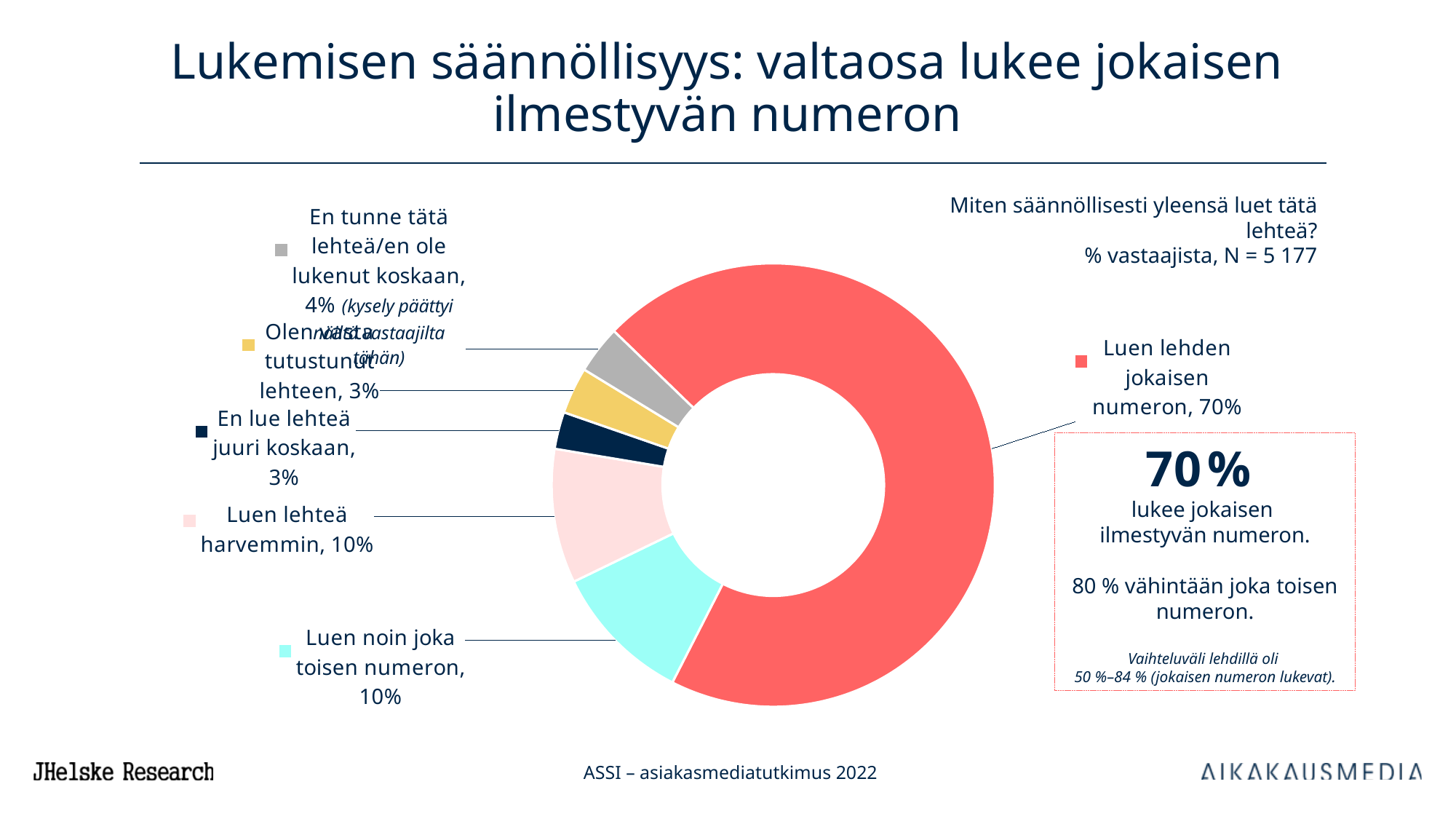
What share of respondents answered "Luen noin joka toisen numeron"? 10% What share of respondents answered "Luen lehden jokaisen numeron"? 70% Which is larger: the share for "Luen lehteä harvemmin" or the share for "Olen vasta tutustunut lehteen"? Luen lehteä harvemmin What kind of chart is shown on the slide? Pie chart (donut) What is the combined share of "Luen lehden jokaisen numeron" and "Luen noin joka toisen numeron"? 80% What share of respondents answered "En tunne tätä lehteä/en ole lukenut koskaan"? 4% What colour is the slice for "Luen lehden jokaisen numeron"? Red What is the number of respondents (N) stated on the chart? 5 177 What is the difference in percentage points between "Luen lehden jokaisen numeron" and "Luen lehteä harvemmin"? 60 percentage points How many categories are shown in the pie chart? 6 Which category has the largest share of the pie? Luen lehden jokaisen numeron What share of respondents answered "En lue lehteä juuri koskaan"? 3%